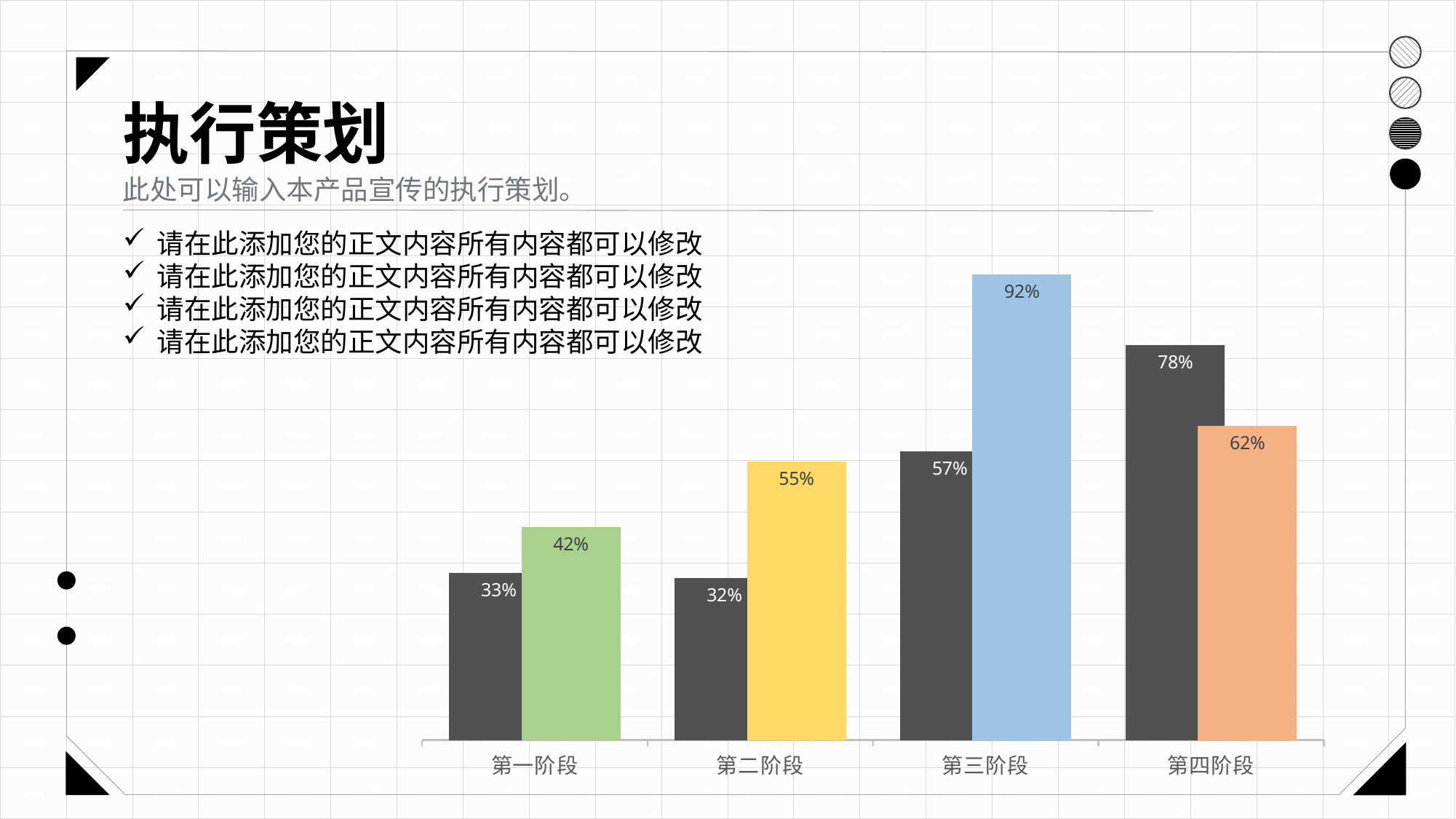
Which category has the highest value among the dark grey bars? 第四阶段 What is the value shown on the green bar for 第一阶段? 42% Which category has the lowest value among the dark grey bars? 第二阶段 What kind of chart is shown on the slide? bar chart What is the title of the slide containing the chart? 执行策划 What is the value shown on the yellow bar for 第二阶段? 55% What is the value shown on the orange bar for 第四阶段? 62% For 第四阶段, which is larger: the dark grey bar or the orange bar? the dark grey bar What is the difference between the blue bar (92%) and the dark grey bar (57%) for 第三阶段? 35% What is the value shown on the dark grey bar for 第一阶段? 33% How many categories are shown on the x axis of the chart? 4 What is the value shown on the dark grey bar for 第三阶段? 57%